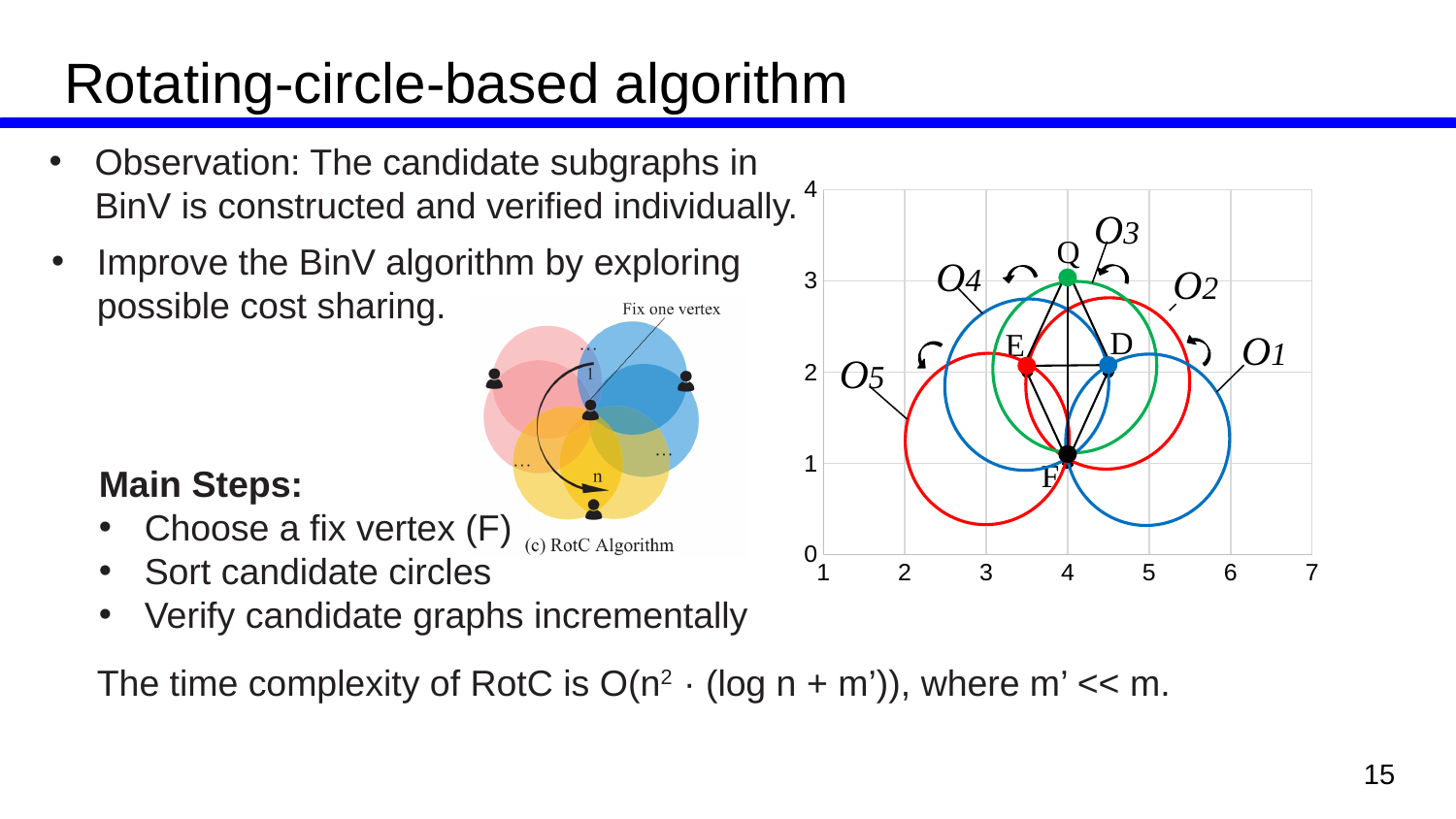
In the coordinate diagram on the right, how many labeled points (Q, E, D, F) are shown? 4 In the coordinate diagram on the right, is the x-coordinate of point D greater or less than 4? greater In the coordinate diagram on the right, which labeled point has the highest y-coordinate? Q In the coordinate diagram on the right, how many labeled circles (O1 to O5) are shown? 5 In the coordinate diagram on the right, what is the x-coordinate of point F? 4 In the coordinate diagram on the right, what is the y-coordinate of point F? 1 In the coordinate diagram on the right, which labeled point has the lowest y-coordinate? F In the coordinate diagram on the right, which point has a larger y-coordinate, Q or D? Q In the coordinate diagram on the right, what is the y-coordinate of point Q? 3 In the coordinate diagram on the right, what is the maximum value shown on the y axis? 4 In the coordinate diagram on the right, what is the maximum value shown on the x axis? 7 In the coordinate diagram on the right, is the x-coordinate of point E greater or less than 4? less